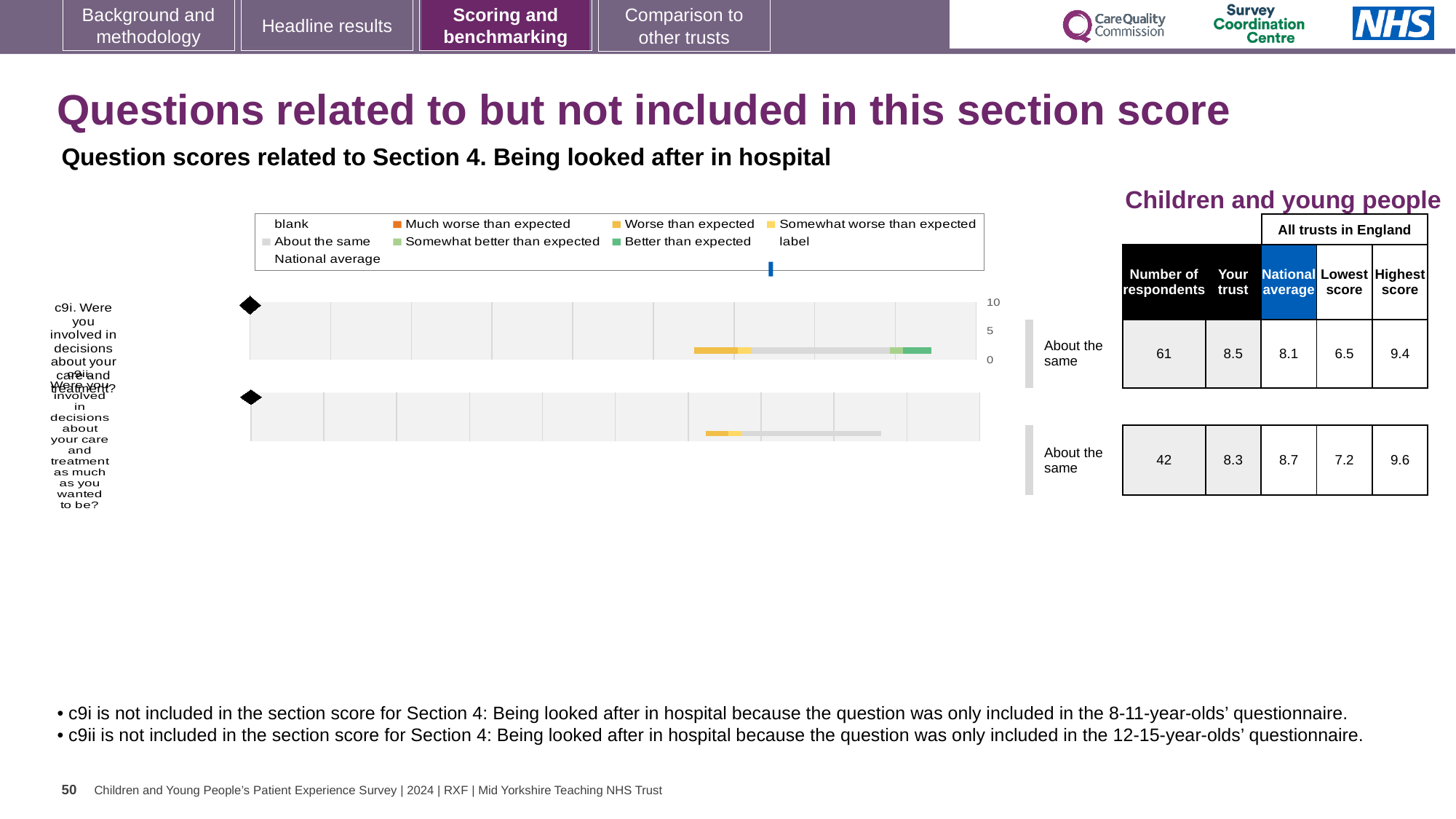
What is the difference between the trust's score and the national average for question c9i? 0.4 For question c9ii, which is higher: the trust's score or the national average? the national average What is the national average score for question c9ii? 8.7 How many questions are plotted on the slide's charts? 2 What kind of chart is used to show the question scores for c9i and c9ii? bar chart What is the highest score across all trusts in England for question c9ii? 9.6 How many respondents answered question c9ii? 42 What is the 'Your trust' score for question c9i? 8.5 For question c9i, which is higher: the trust's score or the national average? the trust's score What is the 'Your trust' score for question c9ii? 8.3 What is the national average score for question c9i? 8.1 What benchmark category is shown next to the chart for question c9i? About the same